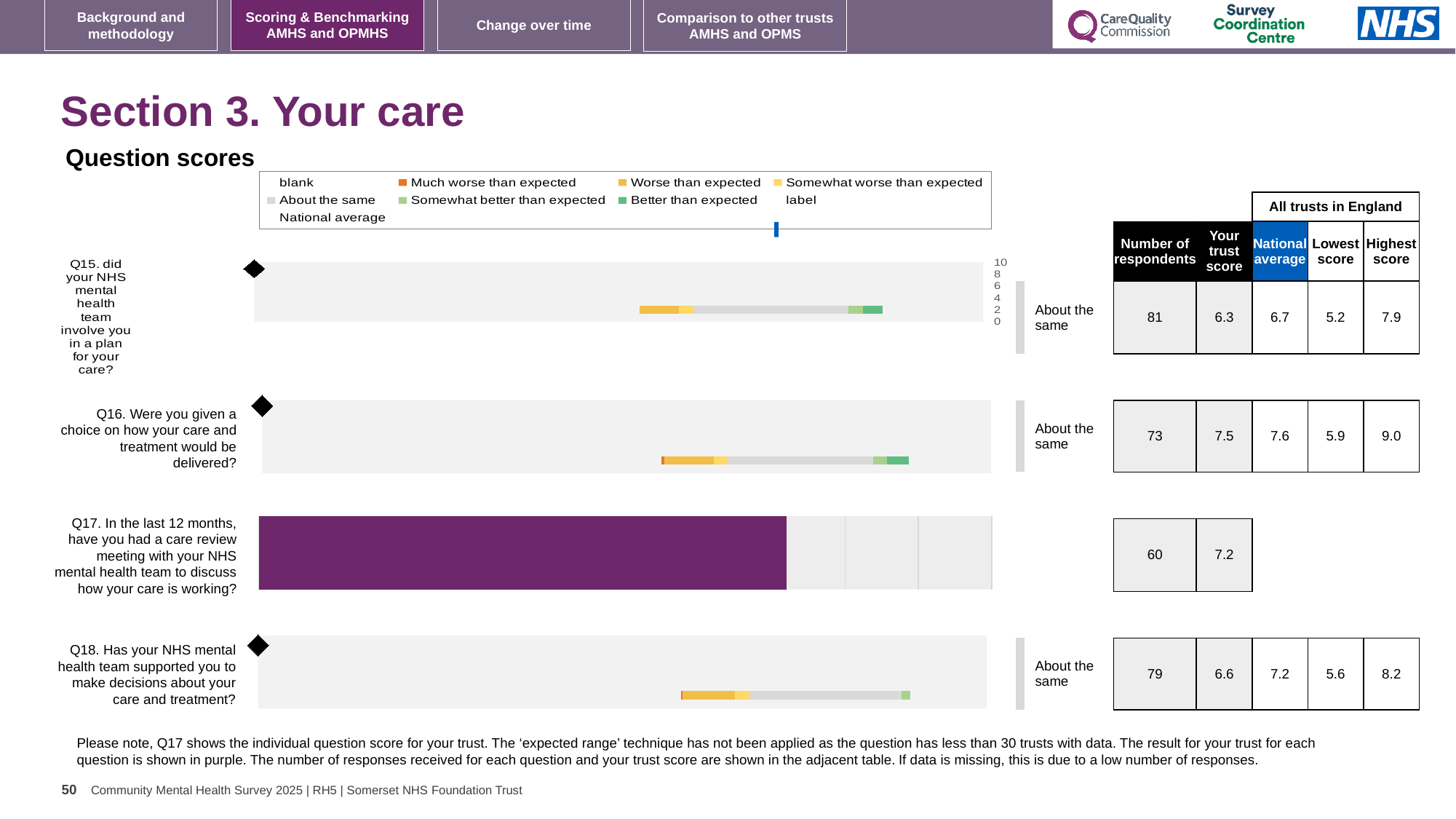
What is the national average for Q15 (did your NHS mental health team involve you in a plan for your care)? 6.7 Which question has the highest 'Highest score' among all trusts in England? Q16 Which question has the lowest trust score? Q15 How many respondents answered Q18 (Has your NHS mental health team supported you to make decisions about your care and treatment)? 79 What is the trust score for Q16 (Were you given a choice on how your care and treatment would be delivered)? 7.5 What kind of chart is used to show the question scores? bar chart What is the difference between the highest score and the lowest score for Q18? 2.6 What is the difference between the national average and the trust score for Q15? 0.4 How many questions are shown in the chart? 4 What colour is the bar for Q17? purple Which question has the highest trust score? Q16 Is the trust score for Q18 higher or lower than the national average for Q18? lower